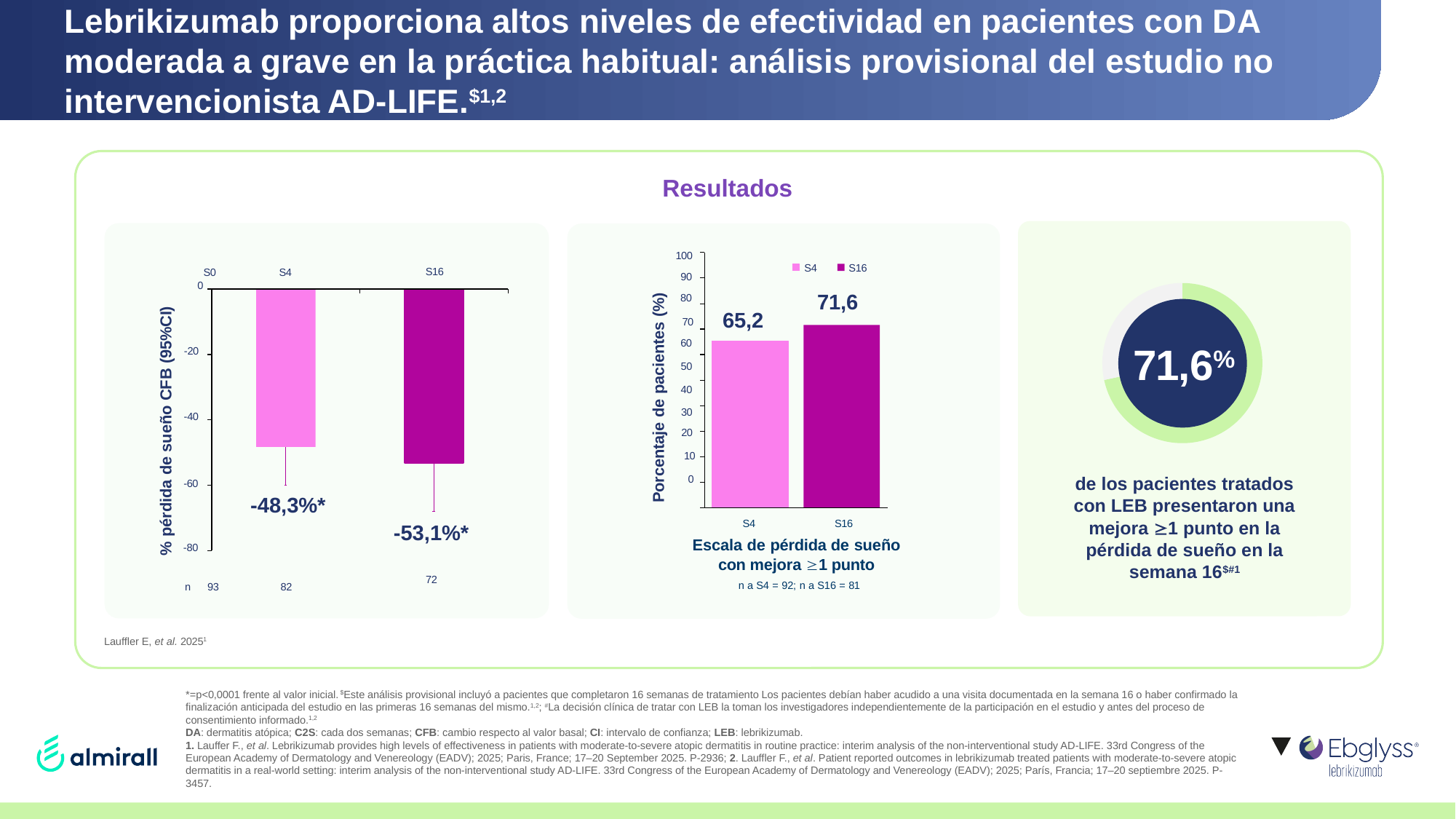
In the middle chart (Porcentaje de pacientes), which bar is higher, S4 or S16? S16 In the middle chart (Porcentaje de pacientes), how many bars are plotted? 2 In the left chart (% pérdida de sueño CFB), what is the n value shown for S0? 93 In the middle chart (Porcentaje de pacientes), what is the value for S16? 71,6 In the left chart (% pérdida de sueño CFB), what is the value shown for S16? -53,1% In the middle chart (Porcentaje de pacientes), what is the value for S4? 65,2 In the middle chart (Porcentaje de pacientes), what is the difference between the S16 and S4 values? 6,4 What percentage is shown in the circular graphic on the right of the slide? 71,6% In the left chart (% pérdida de sueño CFB), what is the value shown for S4? -48,3% In the middle chart (Porcentaje de pacientes), how many series does the legend list? 2 In the middle chart (Porcentaje de pacientes), what is the label of the vertical axis? Porcentaje de pacientes (%) In the left chart (% pérdida de sueño CFB), what kind of chart is it? bar chart